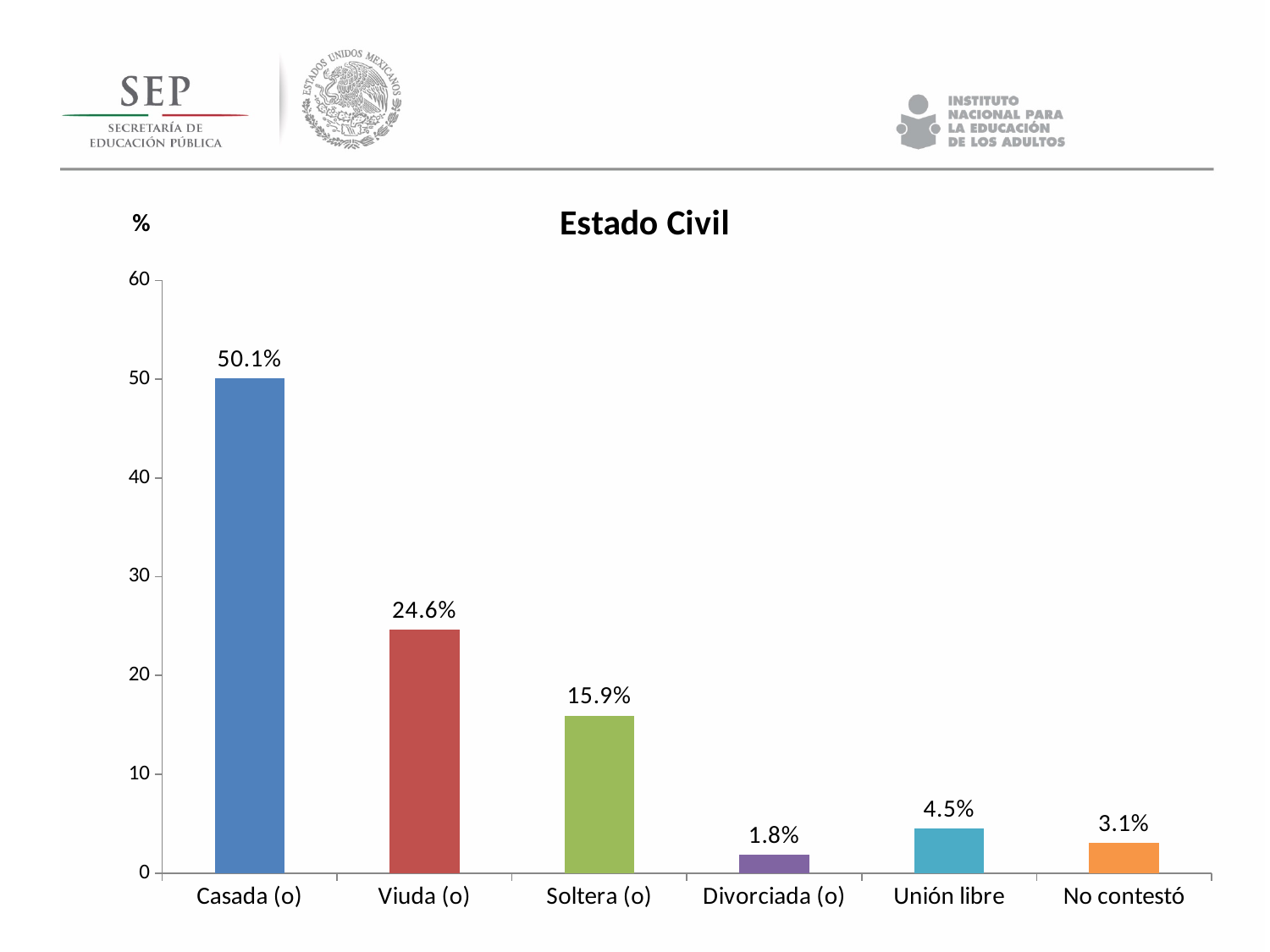
What is the value for Casada (o)? 50.1% What is the difference between the values for Casada (o) and Viuda (o)? 25.5% What is the difference between the values for Soltera (o) and Divorciada (o)? 14.1% Which is larger, the value for Unión libre or the value for No contestó? Unión libre Which category has the lowest value? Divorciada (o) What is the value for No contestó? 3.1% What kind of chart is this? Bar chart What is the title of the chart? Estado Civil Which category has the highest value? Casada (o) What is the value for Viuda (o)? 24.6% How many categories are shown on the x axis? 6 What is the value for Unión libre? 4.5%